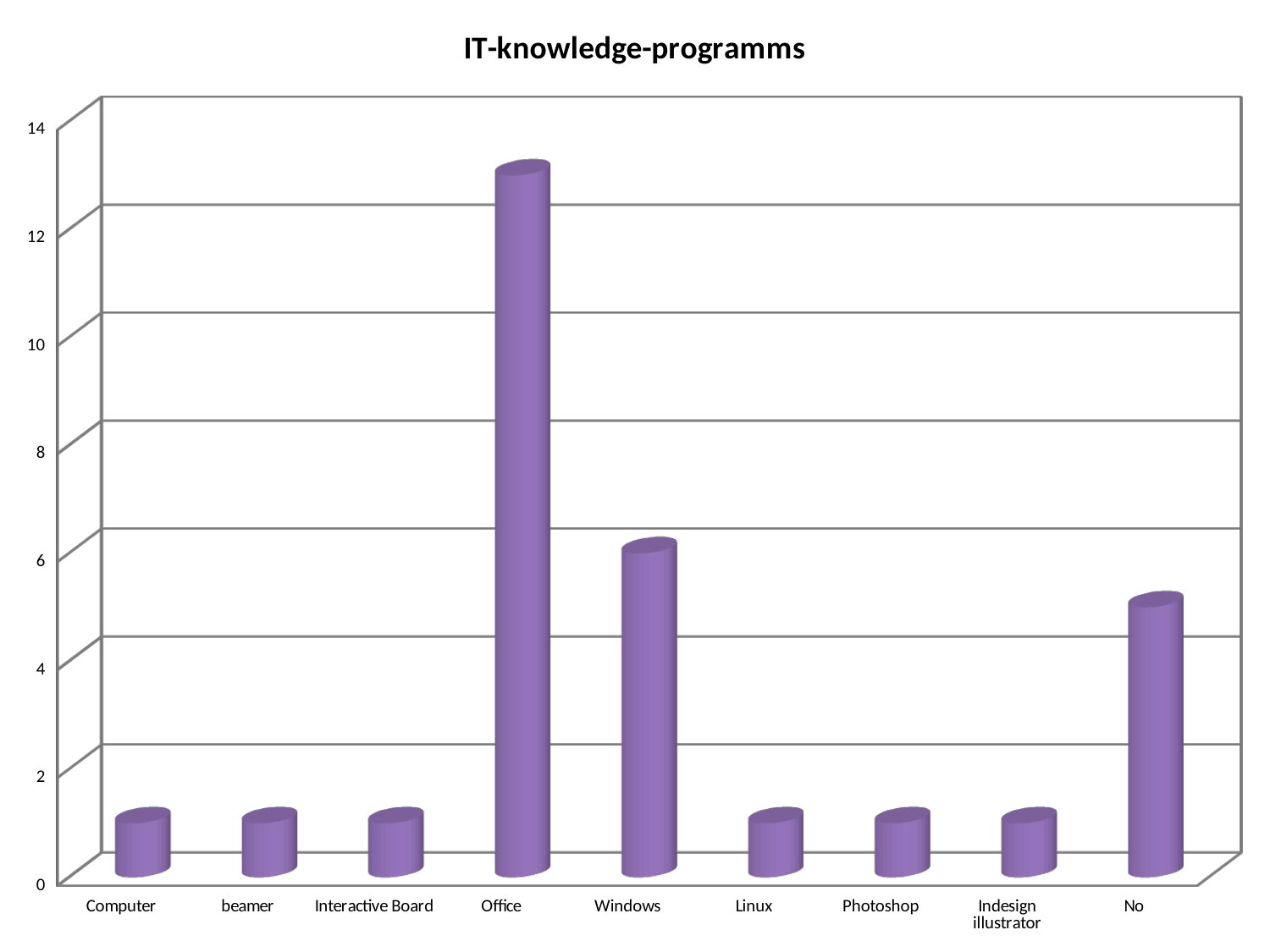
Which has a larger value, Office or Windows? Office Is the value for No greater or less than 4? greater Which has a larger value, Windows or No? Windows What colour are the bars in the chart? purple What is the title of the chart? IT-knowledge-programms How many categories are shown on the x axis of the chart? 9 Is the value for No greater or less than 6? less What kind of chart is shown on the slide? bar chart Is the value for Computer greater or less than 2? less Which category has the highest value in the chart? Office